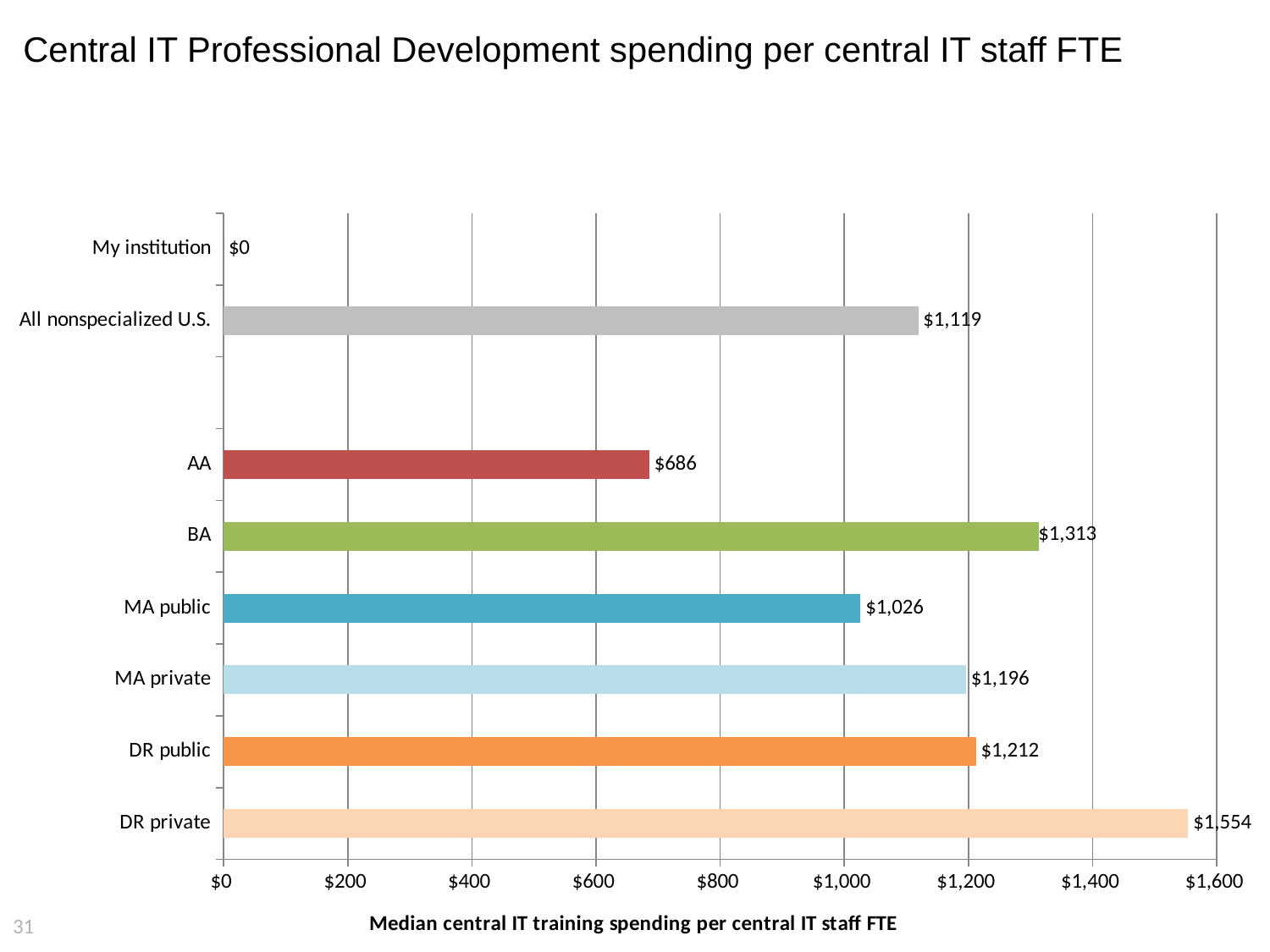
Which category has the highest value? DR private What is the difference between the values for DR private and DR public? $342 Which is larger, the value for MA private or the value for MA public? MA private What is the x-axis title of the chart? Median central IT training spending per central IT staff FTE What is the value for DR private? $1,554 What is the value for All nonspecialized U.S.? $1,119 Among the institution-type categories (AA through DR private), which has the lowest value? AA What is the difference between the values for BA and AA? $627 What is the value for MA public? $1,026 Is the value for BA greater or less than $1,200? greater What kind of chart is shown on the slide? bar chart What is the value for My institution? $0